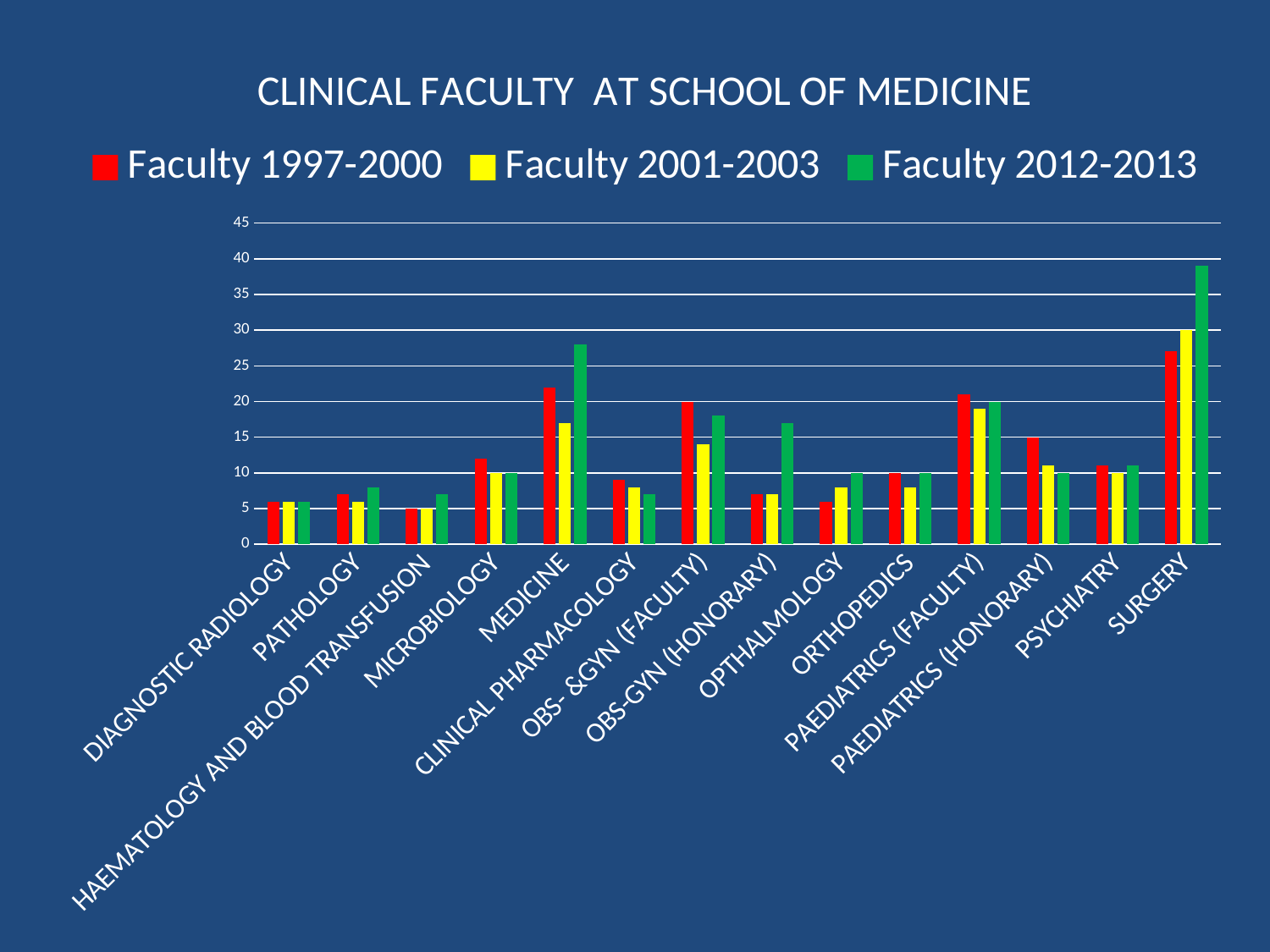
Which department has the highest Faculty 1997-2000 value? SURGERY Is the Faculty 2012-2013 value for MEDICINE greater or less than 25? greater How many series does the legend list? 3 How many departments (categories) are shown on the x axis? 14 For OBS-GYN (HONORARY), which is larger: the Faculty 1997-2000 value or the Faculty 2012-2013 value? Faculty 2012-2013 Is the Faculty 2012-2013 value for SURGERY greater or less than 35? greater What kind of chart is shown on the slide? bar chart Which department has the highest Faculty 2012-2013 value? SURGERY For PAEDIATRICS (HONORARY), which is larger: the Faculty 1997-2000 value or the Faculty 2012-2013 value? Faculty 1997-2000 Is the Faculty 1997-2000 value for PATHOLOGY greater or less than 10? less What colour represents the Faculty 2001-2003 series? yellow